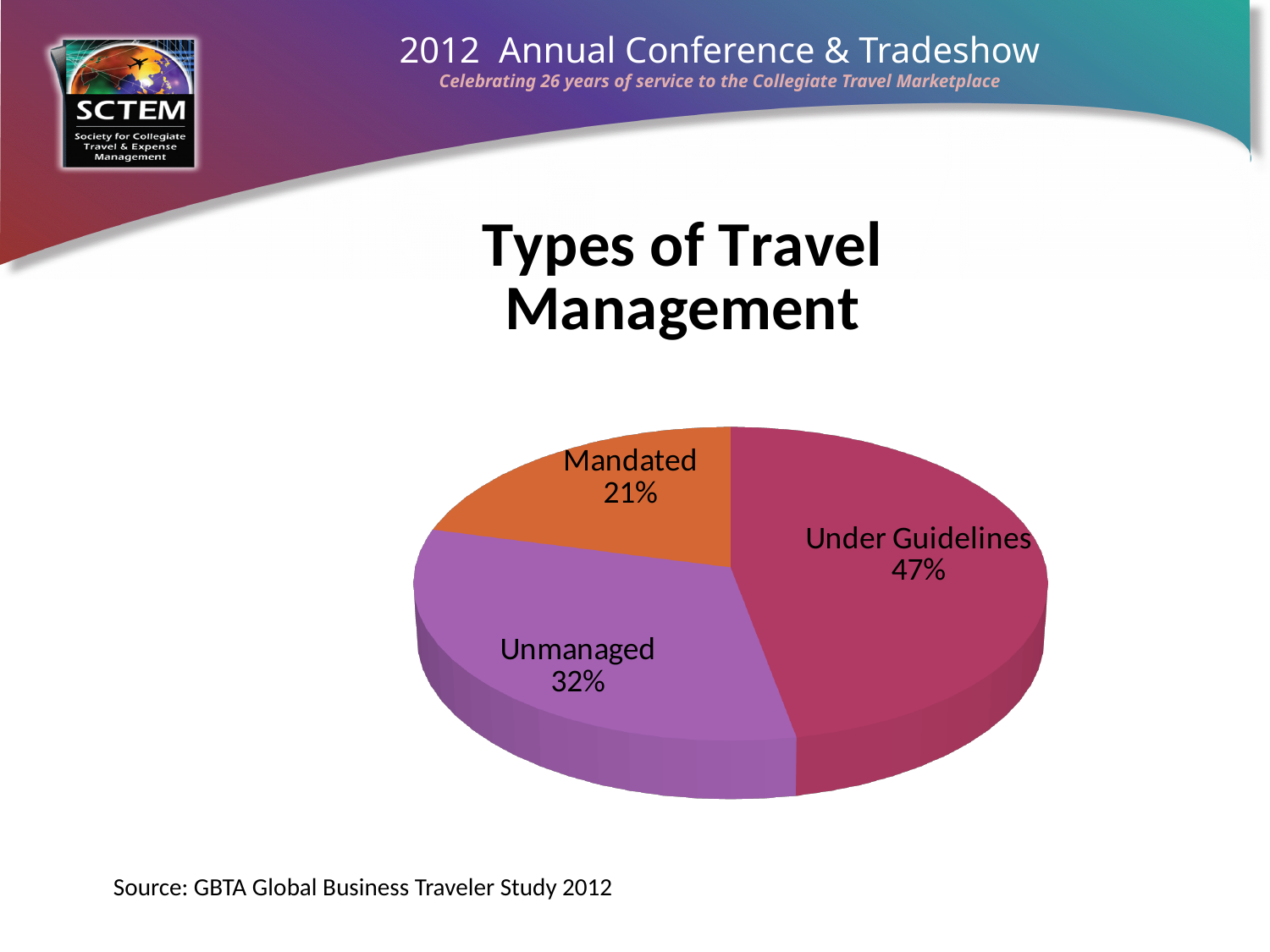
What is the difference in percentage points between Under Guidelines and Unmanaged? 15 What share of the pie is Under Guidelines? 47% What kind of chart is shown on the slide? Pie chart What is the title of the chart on the slide? Types of Travel Management Which is larger, the Unmanaged slice or the Mandated slice? Unmanaged What share of the pie is Mandated? 21% How many categories are shown in the pie chart? 3 Which category has the smallest slice of the pie? Mandated What colour is the Mandated slice? Orange What is the difference in percentage points between Unmanaged and Mandated? 11 What share of the pie is Unmanaged? 32% Which category has the largest slice of the pie? Under Guidelines